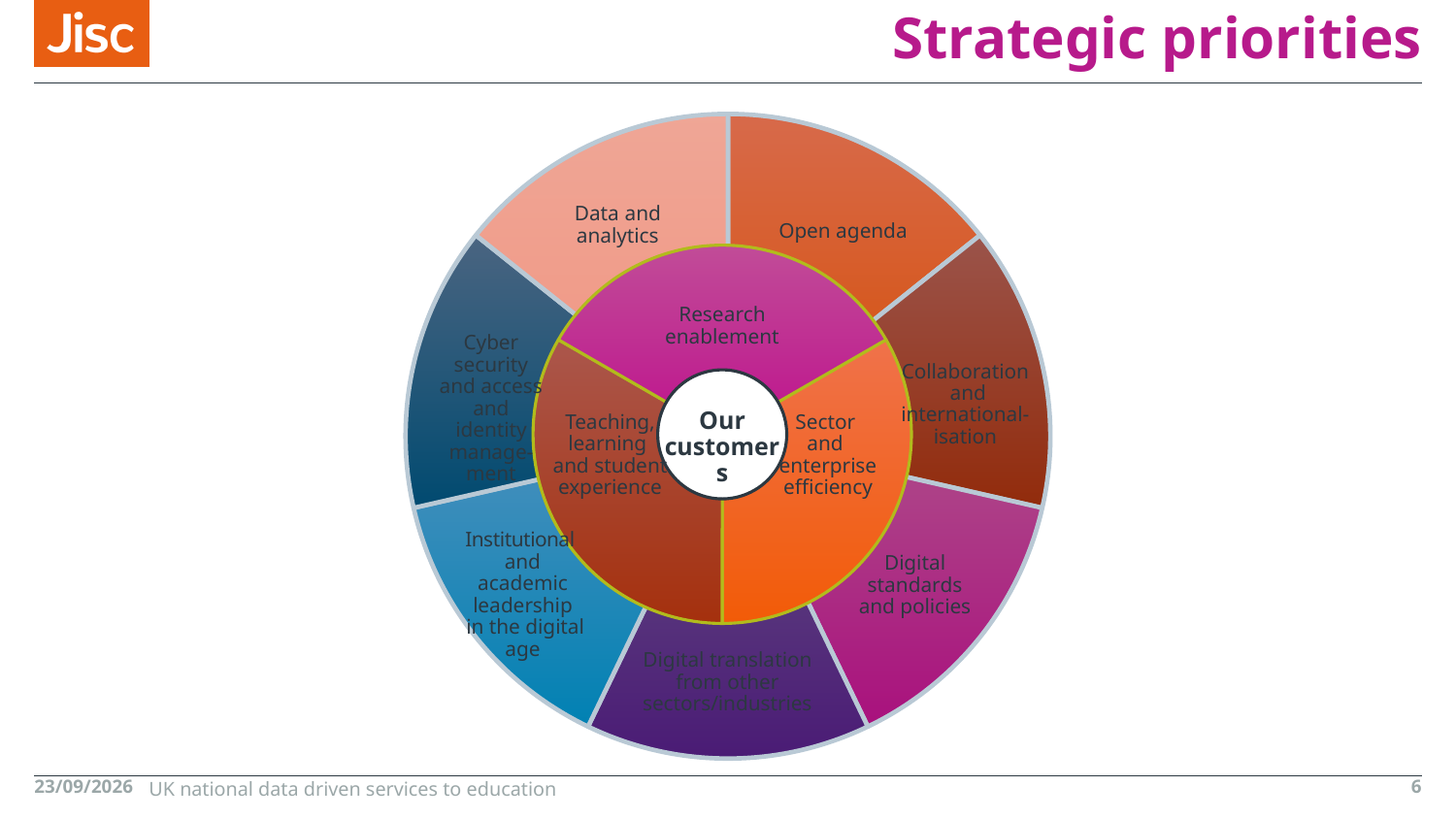
How many segments are in the outer ring of the diagram? 7 How many segments are in the inner ring of the diagram? 3 What is the title of the slide containing the diagram? Strategic priorities What label is shown in the centre circle of the diagram? Our customers Which inner-ring segment sits at the top of the diagram? Research enablement